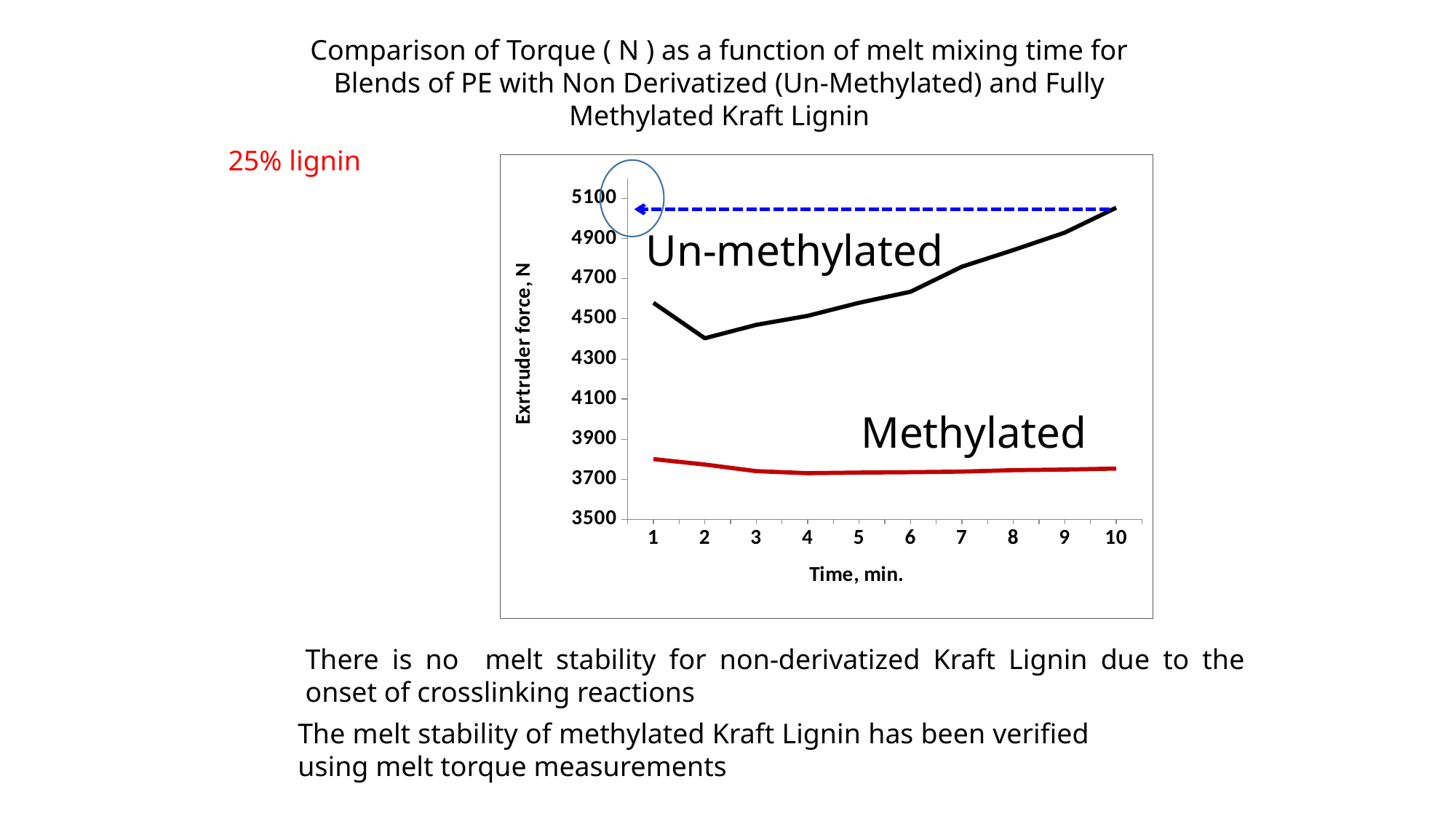
How many time points are plotted for each series? 10 At which time does the Un-methylated series reach its lowest value? 2 Is the Methylated value at 10 min greater or less than 3900? less Is the Methylated value at 1 min greater or less than 3900? less Is the Un-methylated value at 2 min greater or less than 4500? less What kind of chart is shown on the slide? line chart At 10 min, which series has the higher extruder force, Un-methylated or Methylated? Un-methylated Does the Un-methylated series rise or fall between 2 min and 10 min? rise How many series are plotted on the chart? 2 At which time does the Un-methylated series reach its highest value? 10 What is the label of the x axis? Time, min.